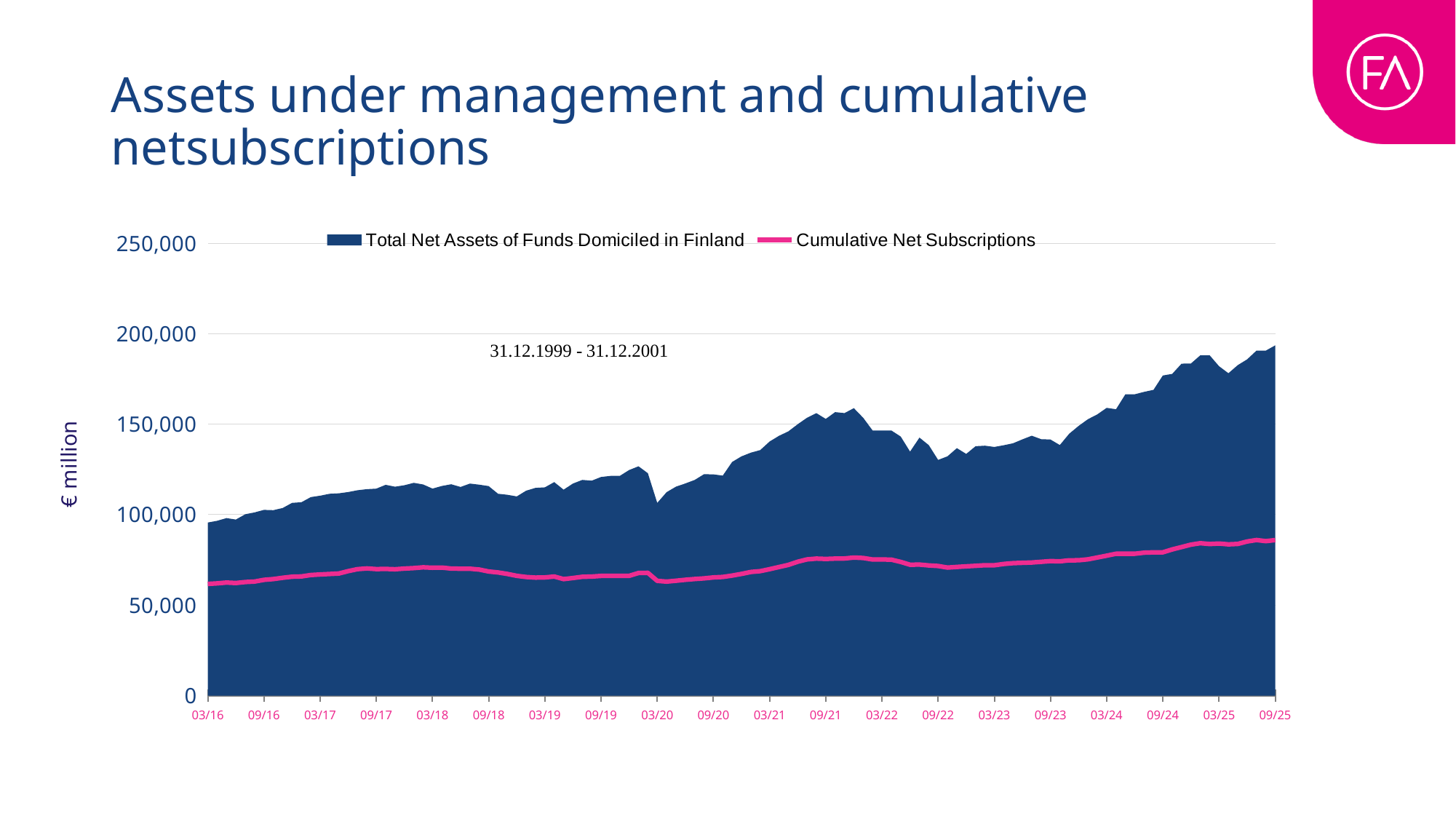
Is the value of Total Net Assets of Funds Domiciled in Finland at 09/25 greater or less than 150,000? greater Overall, does Total Net Assets of Funds Domiciled in Finland rise or fall from 03/16 to 09/25? rise What kind of chart is shown on the slide? Area chart with a line How many series does the chart legend list? 2 What unit is shown on the y-axis label? € million How many date labels are shown on the x axis? 20 Is the value of Total Net Assets of Funds Domiciled in Finland at 03/18 greater or less than 150,000? less Is the value of Total Net Assets of Funds Domiciled in Finland at 09/24 greater or less than 150,000? greater Overall, does Cumulative Net Subscriptions rise or fall from 03/16 to 09/25? rise At 09/25, which series has the higher value: Total Net Assets of Funds Domiciled in Finland or Cumulative Net Subscriptions? Total Net Assets of Funds Domiciled in Finland